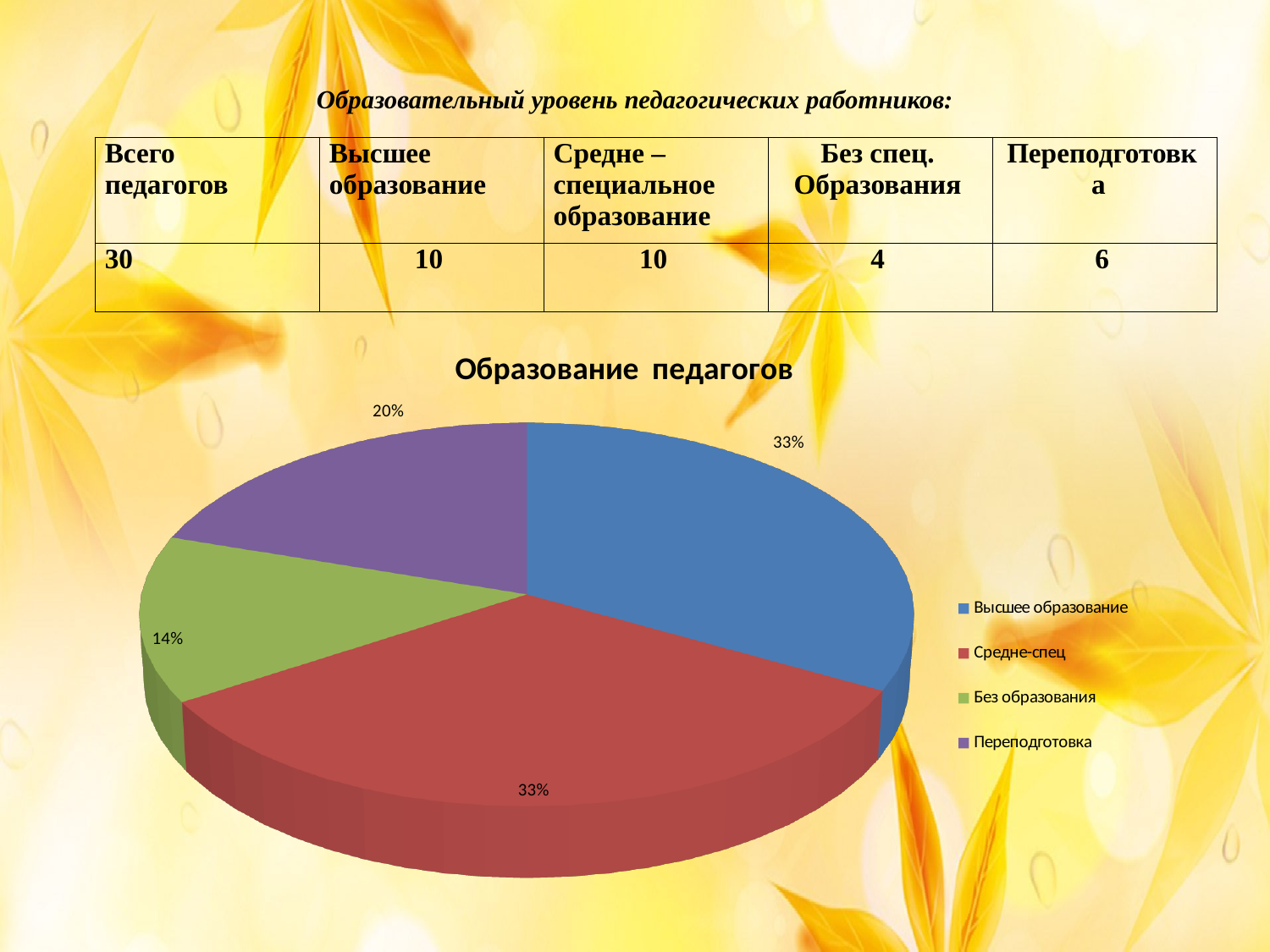
What kind of chart is shown on the slide? Pie chart What colour is the slice for Высшее образование? Blue Which category has the smallest slice of the pie? Без образования What share of the pie does Переподготовка represent? 20% What share of the pie does Средне-спец represent? 33% Which slice is larger: Переподготовка or Без образования? Переподготовка What share of the pie does Высшее образование represent? 33% What is the title of the chart? Образование педагогов By how many percentage points does Переподготовка exceed Без образования? 6 percentage points How many entries does the legend list? 4 How many slices does the pie chart have? 4